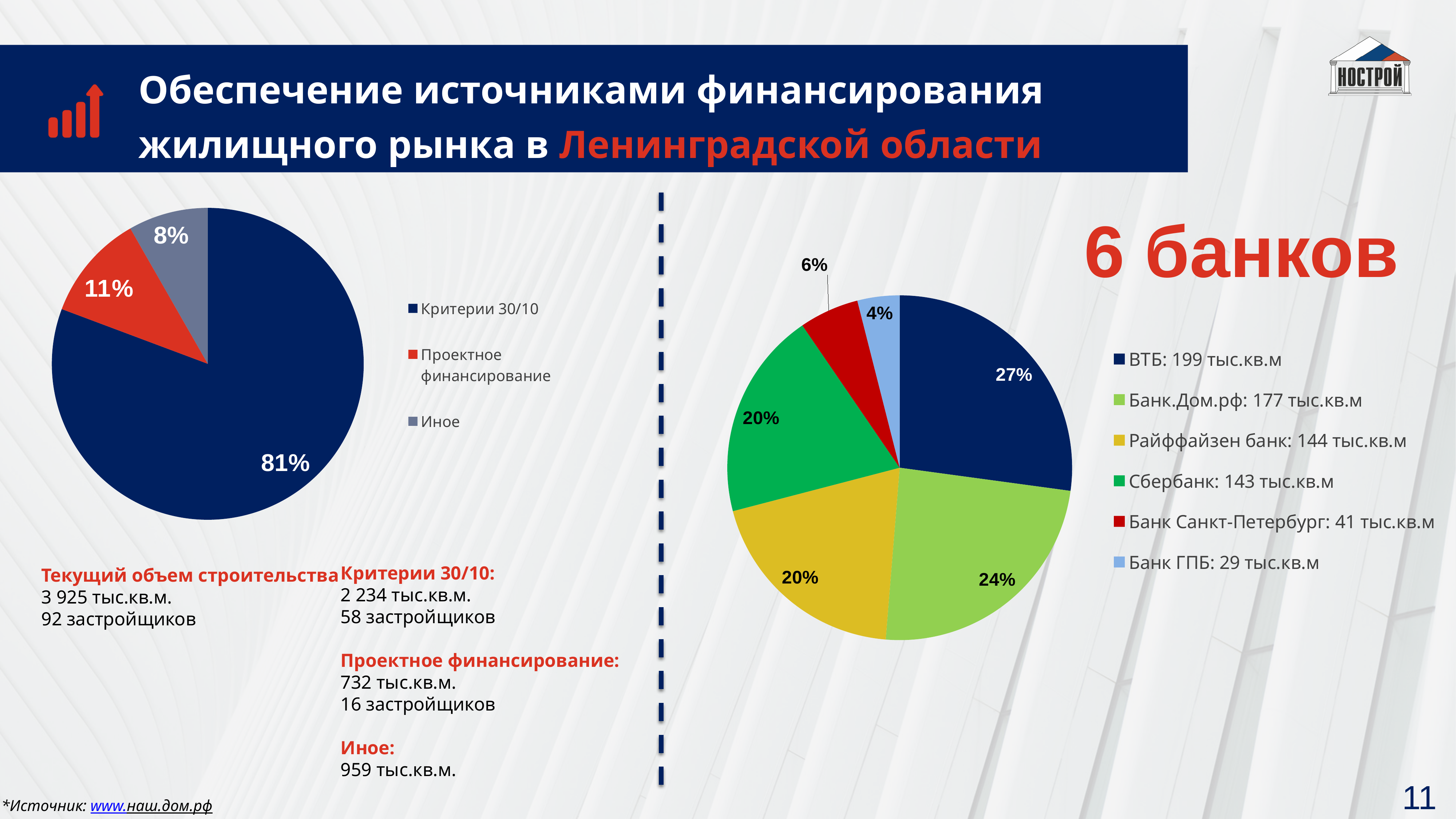
On the right pie chart, which bank has the smallest slice? Банк ГПБ What kind of chart is the chart on the right side of the slide? Pie chart On the right pie chart, how many banks does the legend list? 6 On the right pie chart, which bank has the largest slice? ВТБ On the right pie chart, what share does the slice for 'Банк ГПБ' have? 4% On the left pie chart, what share does the slice 'Проектное финансирование' have? 11% On the left pie chart, which category has the smallest slice? Иное On the left pie chart, how many slices are there? 3 On the left pie chart, what share does the slice 'Критерии 30/10' have? 81% On the right pie chart, which slice is larger: 'Сбербанк' or 'Банк Санкт-Петербург'? Сбербанк On the right pie chart, what is the difference in percentage points between the 'ВТБ' slice and the 'Банк.Дом.рф' slice? 3 percentage points